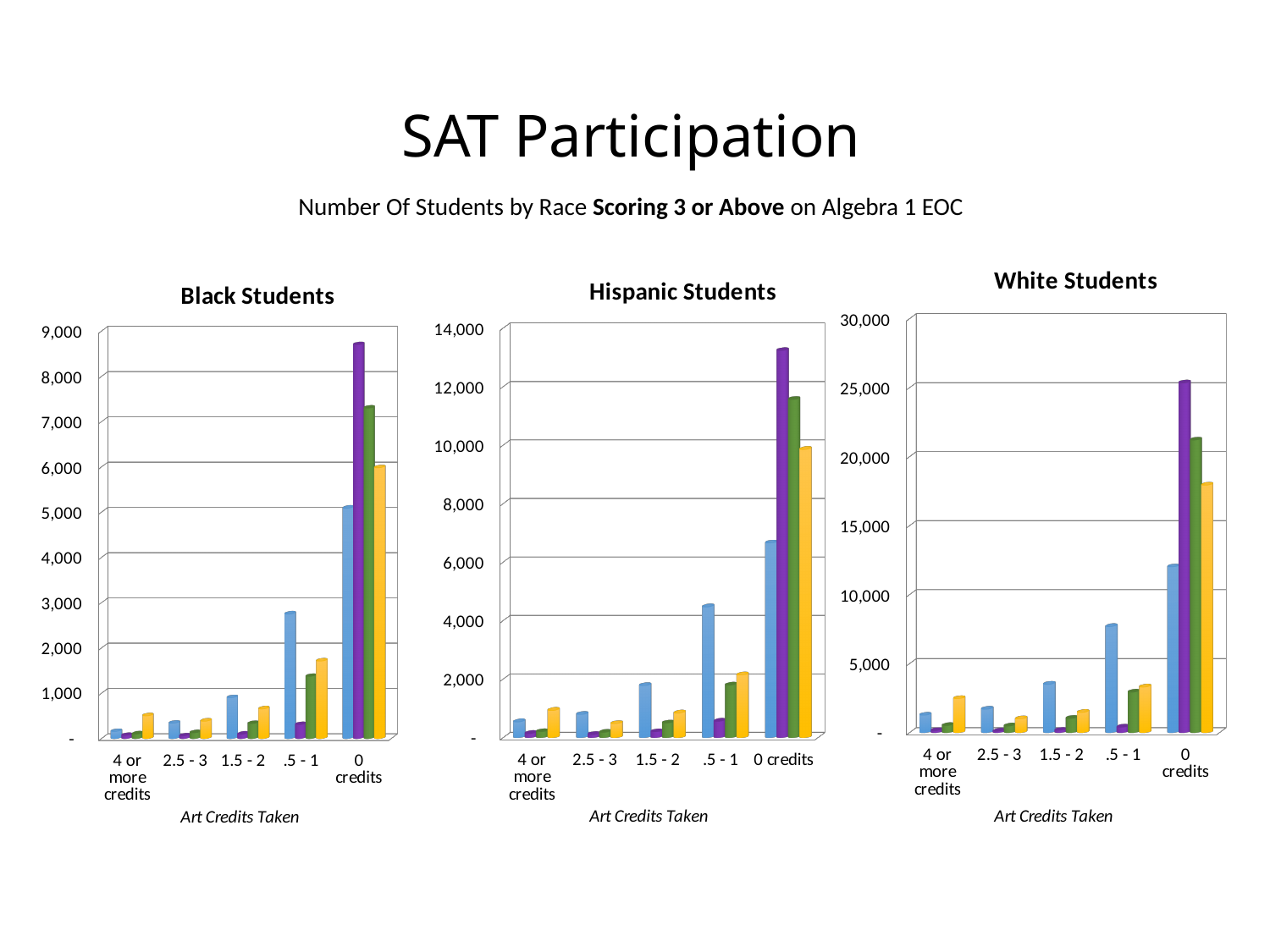
In the White Students chart, which is larger for 0 credits: the purple bar or the yellow bar? the purple bar In the Black Students chart, is the purple bar for 0 credits greater or less than 8,000? greater What is the highest value labelled on the y axis of the White Students chart? 30,000 What kind of chart is the Black Students chart? bar chart In the White Students chart, is the blue bar for .5 - 1 credits greater or less than 5,000? greater In the Black Students chart, do the blue bars rise or fall moving from '4 or more credits' to '0 credits' along the x axis? rise In the Hispanic Students chart, which is larger: the blue bar for .5 - 1 credits or the blue bar for 1.5 - 2 credits? .5 - 1 credits What is the x-axis title shown under each of the three charts? Art Credits Taken In the White Students chart, is the yellow bar for 0 credits greater or less than 20,000? less How many art-credit categories are shown on the x axis of the Hispanic Students chart? 5 In the Black Students chart, which art-credit category has the tallest bars? 0 credits